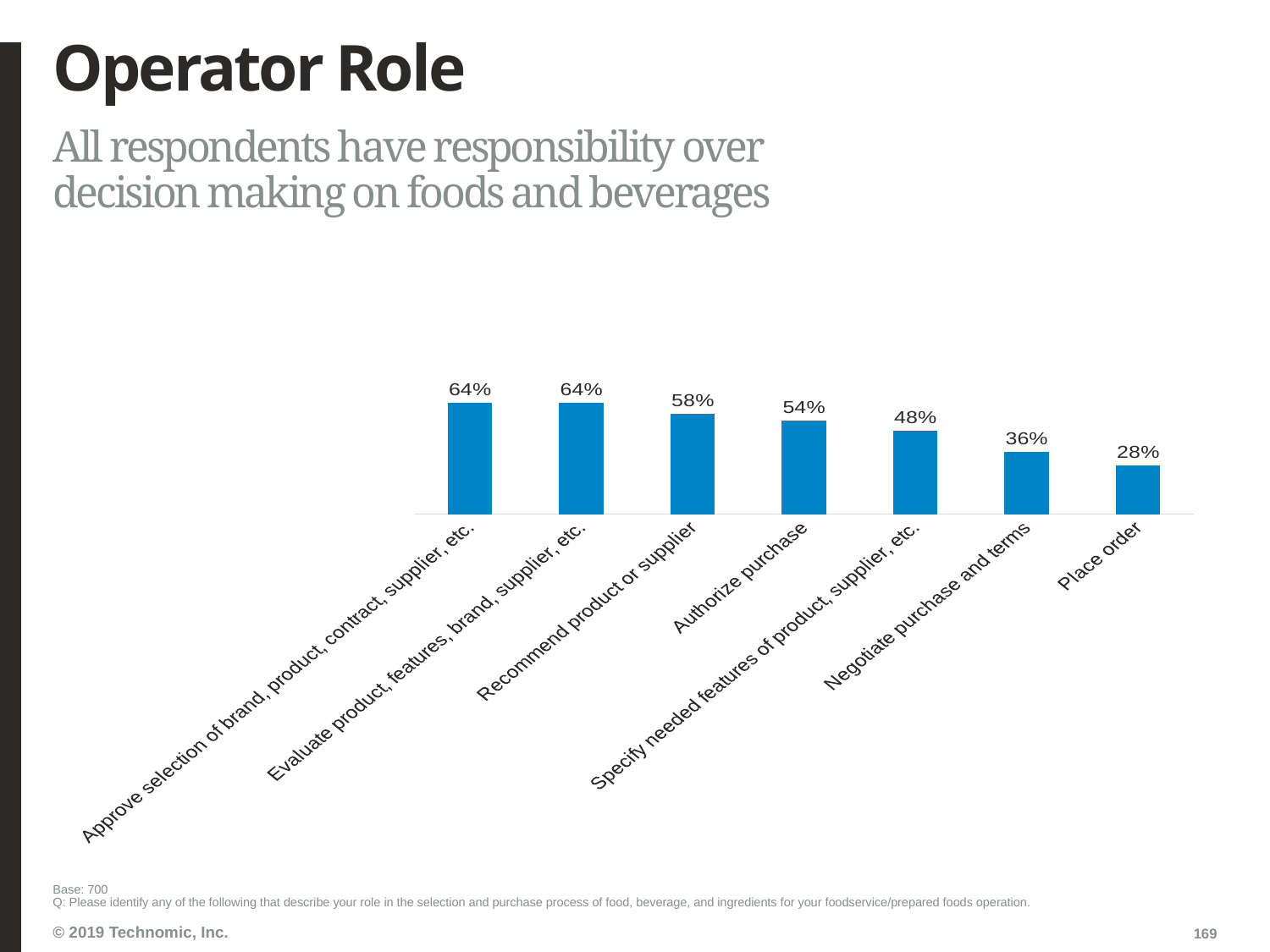
Which is larger: "Negotiate purchase and terms" or "Specify needed features of product, supplier, etc."? Specify needed features of product, supplier, etc. What is the difference between "Recommend product or supplier" and "Specify needed features of product, supplier, etc."? 10% What is the difference between "Authorize purchase" and "Place order"? 26% What kind of chart is shown on the slide? Bar chart Do the values rise or fall moving from left to right across the chart? Fall Which role has the lowest percentage of respondents? Place order How many roles (categories) are shown on the chart? 7 What is the value for "Negotiate purchase and terms"? 36% What percentage of respondents say they place orders? 28% What is the value for "Authorize purchase"? 54% What is the value for "Recommend product or supplier"? 58% What is the highest value shown on the chart? 64%